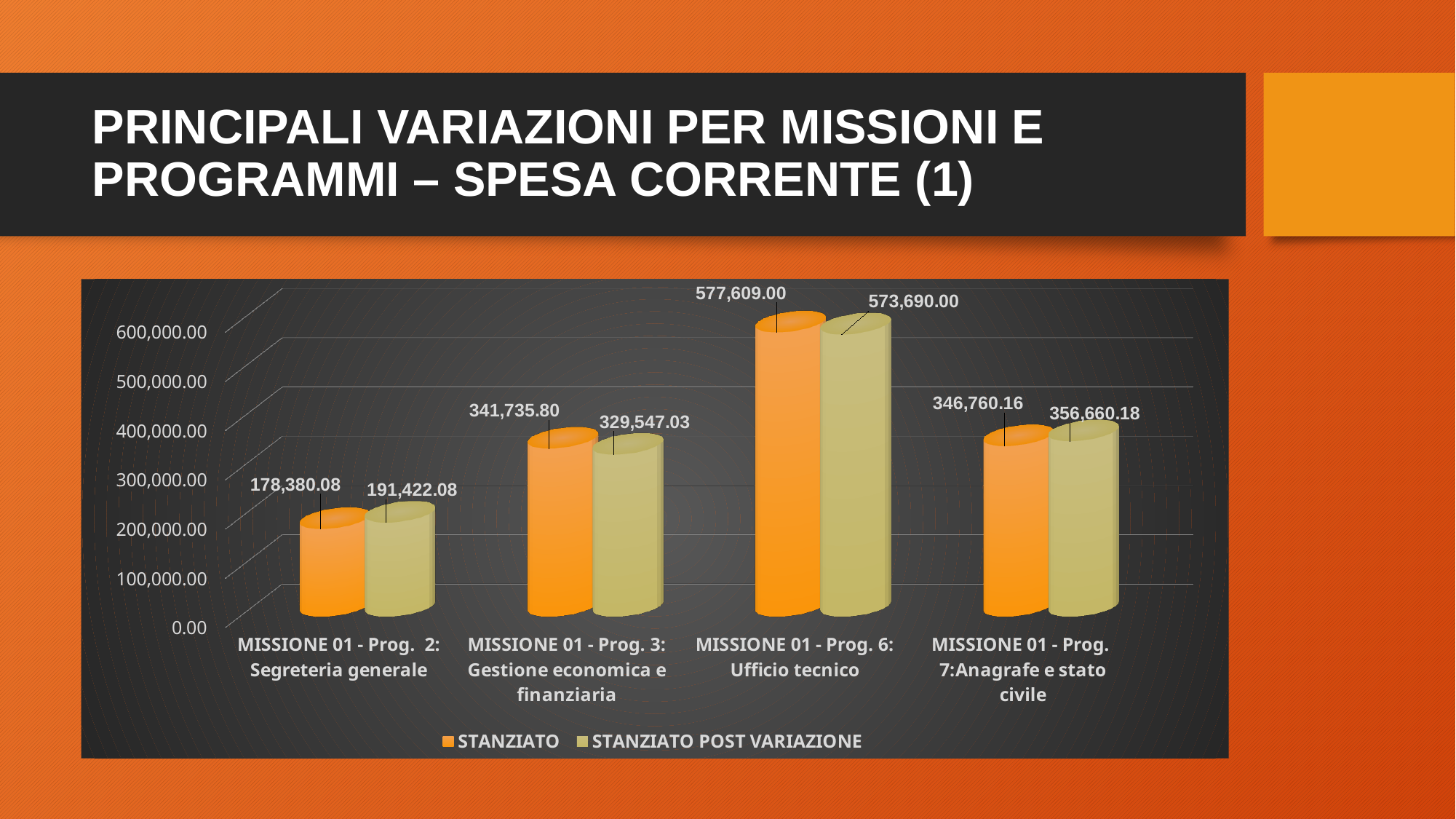
Which category has the lowest STANZIATO POST VARIAZIONE value? MISSIONE 01 - Prog. 2: Segreteria generale For MISSIONE 01 - Prog. 3: Gestione economica e finanziaria, which is larger: STANZIATO or STANZIATO POST VARIAZIONE? STANZIATO What is the STANZIATO value for MISSIONE 01 - Prog. 7: Anagrafe e stato civile? 346,760.16 How many series does the legend list? 2 What is the STANZIATO POST VARIAZIONE value for MISSIONE 01 - Prog. 3: Gestione economica e finanziaria? 329,547.03 How many categories are shown on the x axis? 4 What is the STANZIATO POST VARIAZIONE value for MISSIONE 01 - Prog. 2: Segreteria generale? 191,422.08 What is the difference between the STANZIATO POST VARIAZIONE and STANZIATO values for MISSIONE 01 - Prog. 2: Segreteria generale? 13,042.00 What kind of chart is shown on the slide? Bar chart Which category has the highest STANZIATO value? MISSIONE 01 - Prog. 6: Ufficio tecnico What is the difference between the STANZIATO and STANZIATO POST VARIAZIONE values for MISSIONE 01 - Prog. 6: Ufficio tecnico? 3,919.00 What is the STANZIATO value for MISSIONE 01 - Prog. 6: Ufficio tecnico? 577,609.00